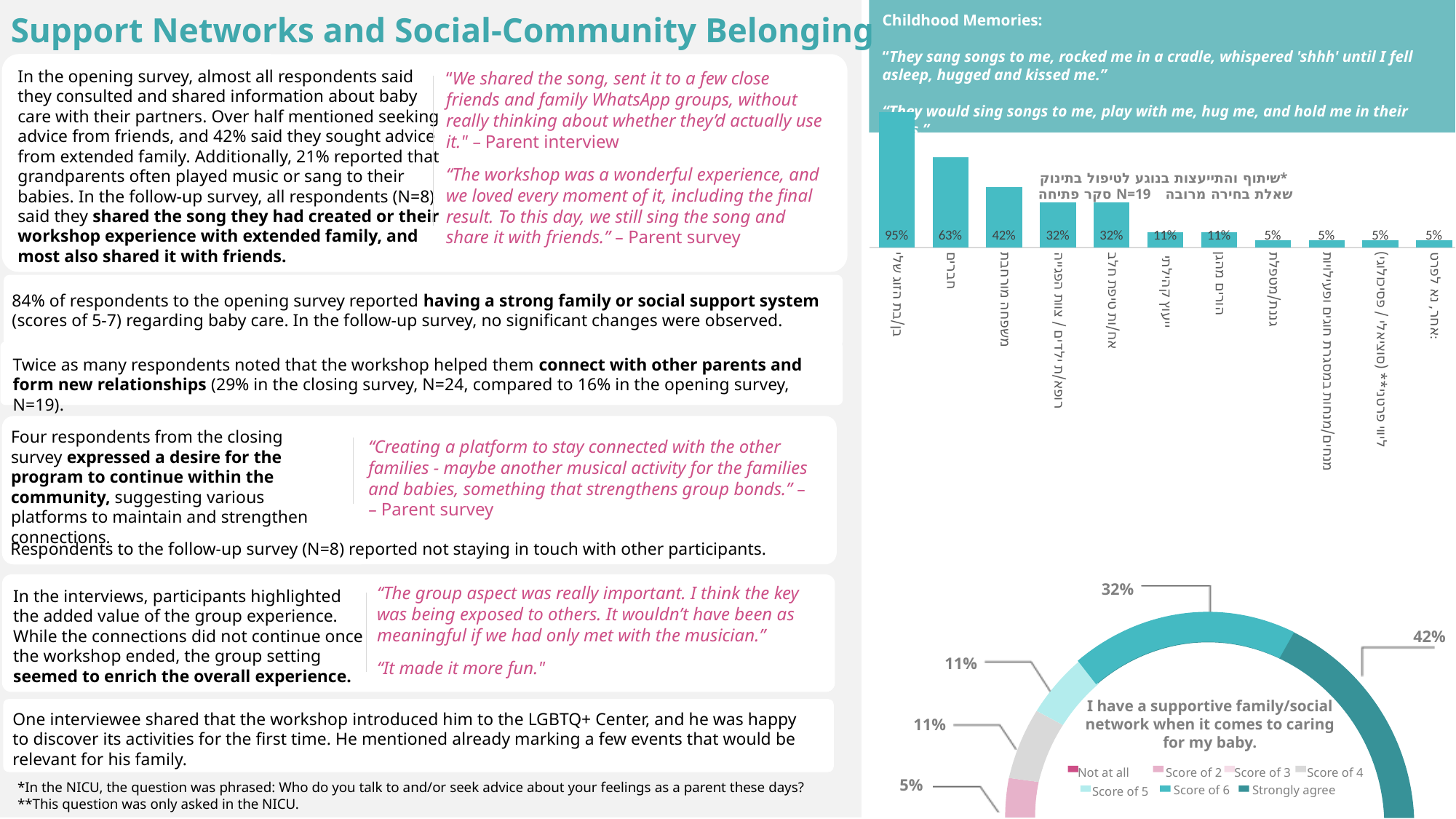
How many bars are plotted in the bar chart at the top right? 11 In the bar chart at the top right, what is the value of the third bar from the left? 42% In the bar chart at the top right, what is the value of the second bar from the left? 63% In the bar chart at the top right, what is the value of the leftmost (tallest) bar? 95% In the bar chart at the top right, do the values rise or fall from left to right? Fall In the bar chart at the top right, what is the lowest value shown? 5% How many entries does the legend of the doughnut chart at the bottom right list? 7 In the doughnut chart at the bottom right, what is the largest share shown? 42% What kind of chart is shown at the bottom right of the slide? Doughnut (pie) chart What kind of chart is shown at the top right of the slide? Bar chart In the bar chart at the top right, what is the difference between the first and second bars from the left? 32 percentage points In the doughnut chart at the bottom right, what is the difference between the 42% slice and the 32% slice? 10 percentage points